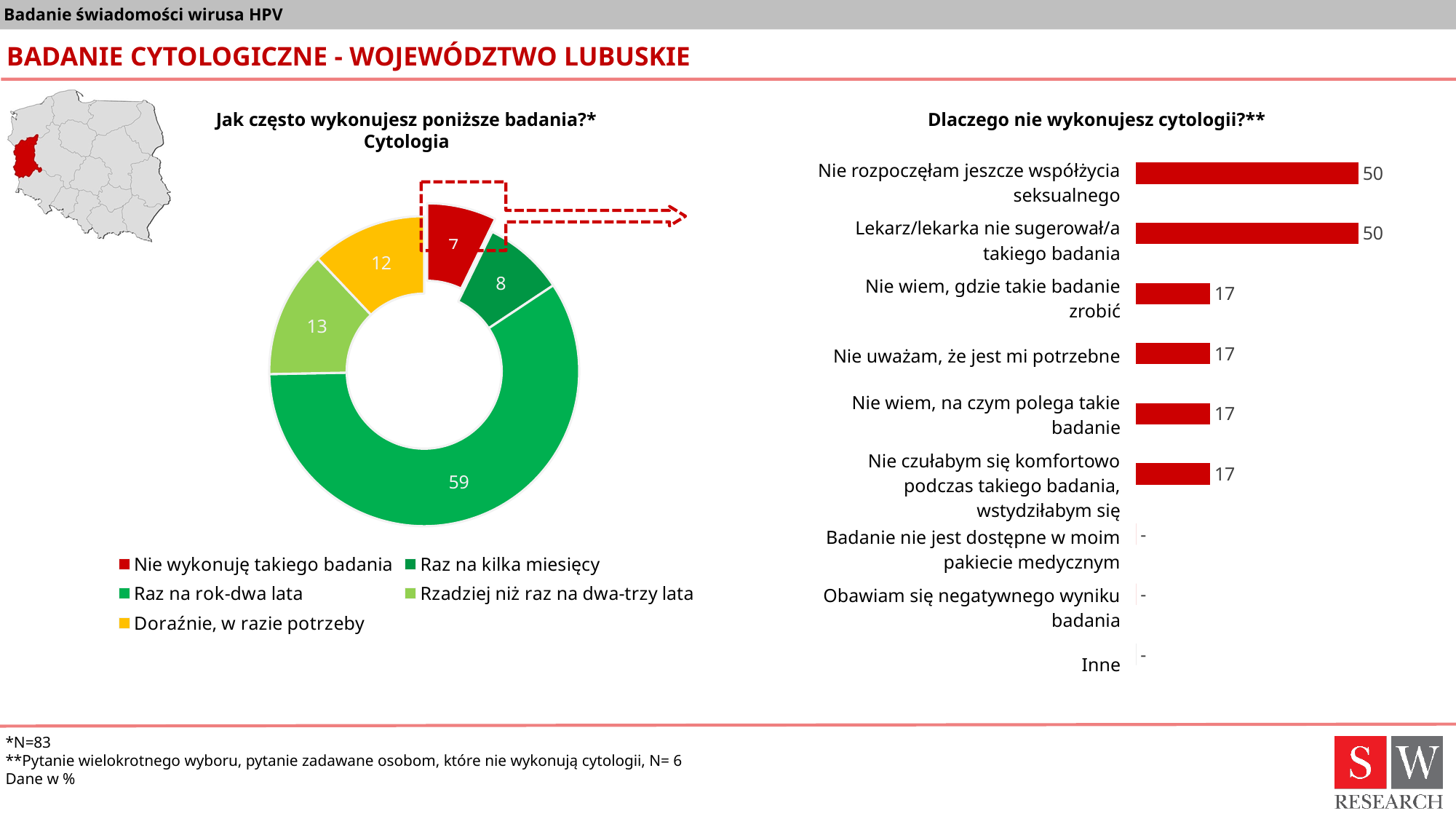
In the bar chart "Dlaczego nie wykonujesz cytologii?", what is the difference between "Nie rozpoczęłam jeszcze współżycia seksualnego" and "Nie wiem, na czym polega takie badanie"? 33 In the donut chart "Jak często wykonujesz poniższe badania? Cytologia", what is the value for "Nie wykonuję takiego badania"? 7 In the donut chart "Jak często wykonujesz poniższe badania? Cytologia", what is the difference between "Rzadziej niż raz na dwa-trzy lata" and "Doraźnie, w razie potrzeby"? 1 In the bar chart "Dlaczego nie wykonujesz cytologii?", what is the value for "Lekarz/lekarka nie sugerował/a takiego badania"? 50 In the bar chart "Dlaczego nie wykonujesz cytologii?", which is larger: "Nie rozpoczęłam jeszcze współżycia seksualnego" or "Nie uważam, że jest mi potrzebne"? Nie rozpoczęłam jeszcze współżycia seksualnego In the donut chart "Jak często wykonujesz poniższe badania? Cytologia", which category has the smallest share? Nie wykonuję takiego badania In the donut chart "Jak często wykonujesz poniższe badania? Cytologia", what is the value for "Raz na rok-dwa lata"? 59 In the donut chart "Jak często wykonujesz poniższe badania? Cytologia", how many categories does the legend list? 5 In the donut chart "Jak często wykonujesz poniższe badania? Cytologia", which category has the largest share? Raz na rok-dwa lata In the donut chart "Jak często wykonujesz poniższe badania? Cytologia", what colour is the "Doraźnie, w razie potrzeby" slice? Yellow What kind of chart is "Dlaczego nie wykonujesz cytologii?"? Bar chart In the bar chart "Dlaczego nie wykonujesz cytologii?", what is the value for "Nie wiem, gdzie takie badanie zrobić"? 17